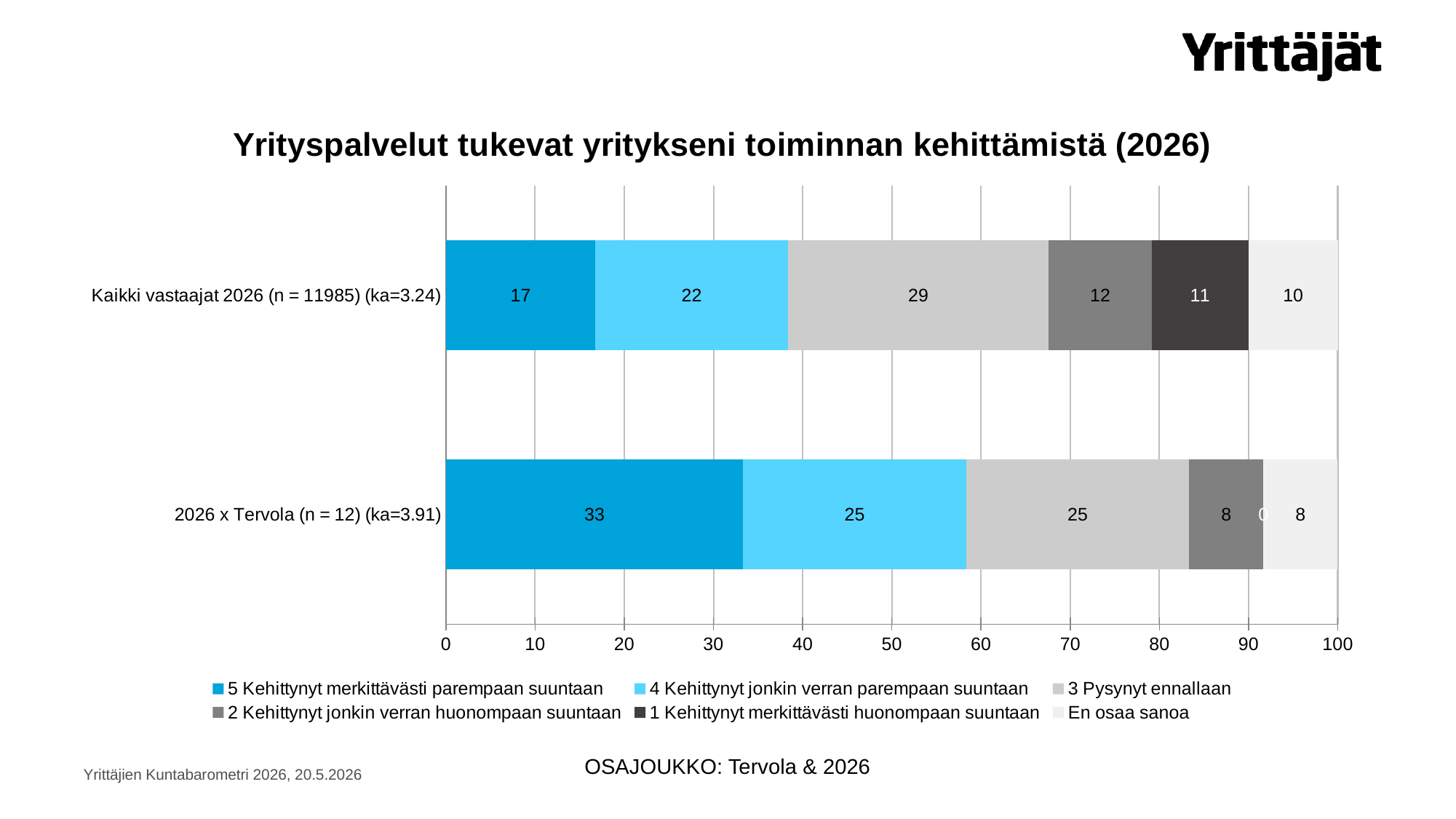
What is the value of "3 Pysynyt ennallaan" for "Kaikki vastaajat 2026 (n = 11985) (ka=3.24)"? 29 What kind of chart is shown on the slide? Stacked bar chart How many series does the legend list? 6 How many categories (bars) are shown in the chart? 2 Which series has the highest value in the "Kaikki vastaajat 2026 (n = 11985) (ka=3.24)" bar? 3 Pysynyt ennallaan What is the value of "1 Kehittynyt merkittävästi huonompaan suuntaan" for "2026 x Tervola (n = 12) (ka=3.91)"? 0 What is the value of "5 Kehittynyt merkittävästi parempaan suuntaan" for "2026 x Tervola (n = 12) (ka=3.91)"? 33 Which category has the larger value for "2 Kehittynyt jonkin verran huonompaan suuntaan": "Kaikki vastaajat 2026 (n = 11985) (ka=3.24)" or "2026 x Tervola (n = 12) (ka=3.91)"? Kaikki vastaajat 2026 (n = 11985) (ka=3.24) What is the title of the chart? Yrityspalvelut tukevat yritykseni toiminnan kehittämistä (2026) Which series has the lowest value in the "2026 x Tervola (n = 12) (ka=3.91)" bar? 1 Kehittynyt merkittävästi huonompaan suuntaan What is the value of "En osaa sanoa" for "Kaikki vastaajat 2026 (n = 11985) (ka=3.24)"? 10 What is the difference between the "5 Kehittynyt merkittävästi parempaan suuntaan" values for "2026 x Tervola (n = 12) (ka=3.91)" and "Kaikki vastaajat 2026 (n = 11985) (ka=3.24)"? 16